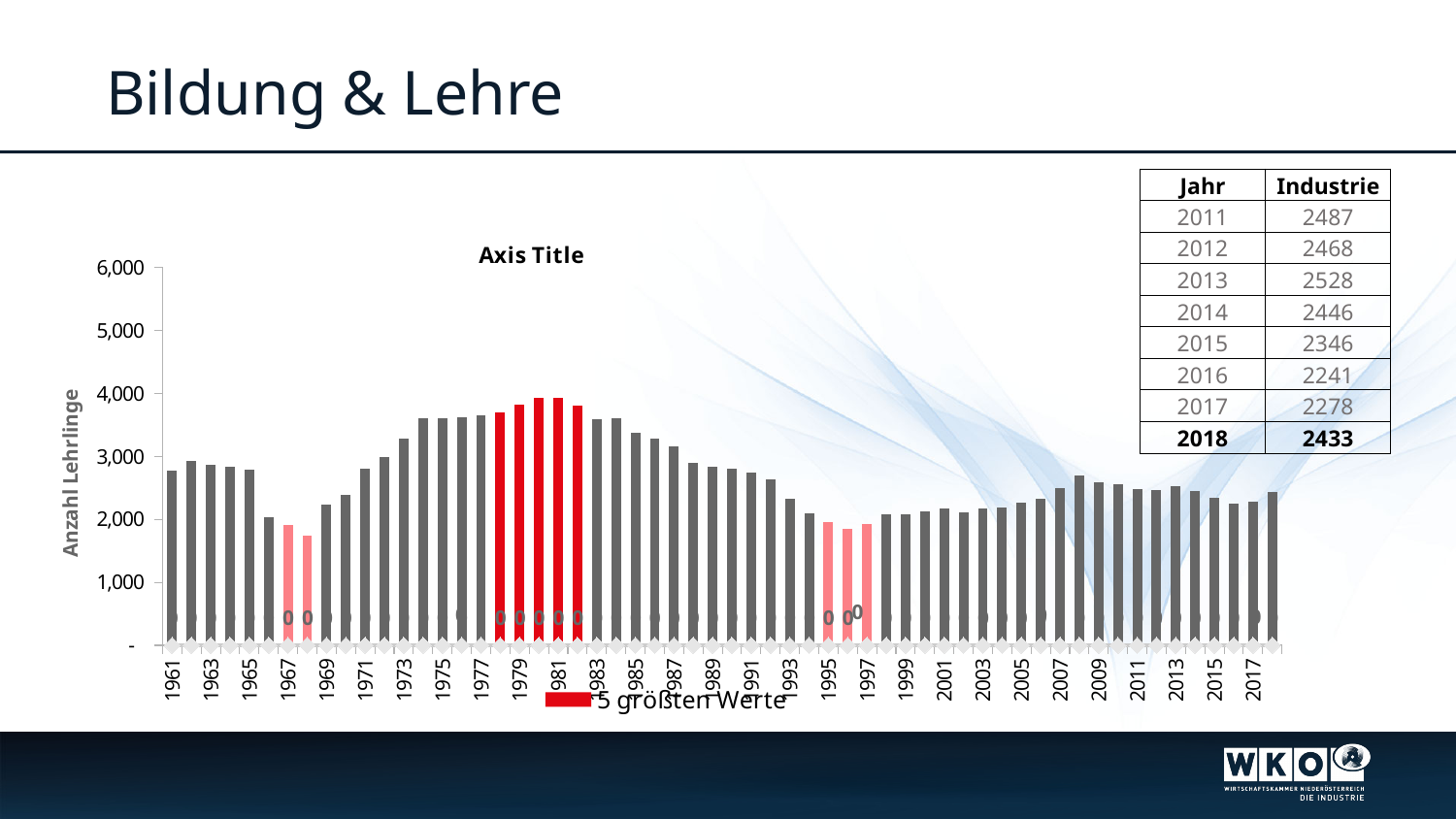
What kind of chart is shown on the slide? bar chart What entry does the chart's legend list? 5 größten Werte Is the value for 1968 greater or less than 2,000? less Is the value for 1975 greater or less than 3,000? greater Is the value for 1980 greater or less than 3,000? greater Do the values rise or fall from 1981 to 1995? fall Which is larger, the value for 1980 or the value for 1995? 1980 How many bars are highlighted in dark red in the chart? 5 Which year has the lowest value in the chart? 1968 What is the title of the vertical axis of the chart? Anzahl Lehrlinge